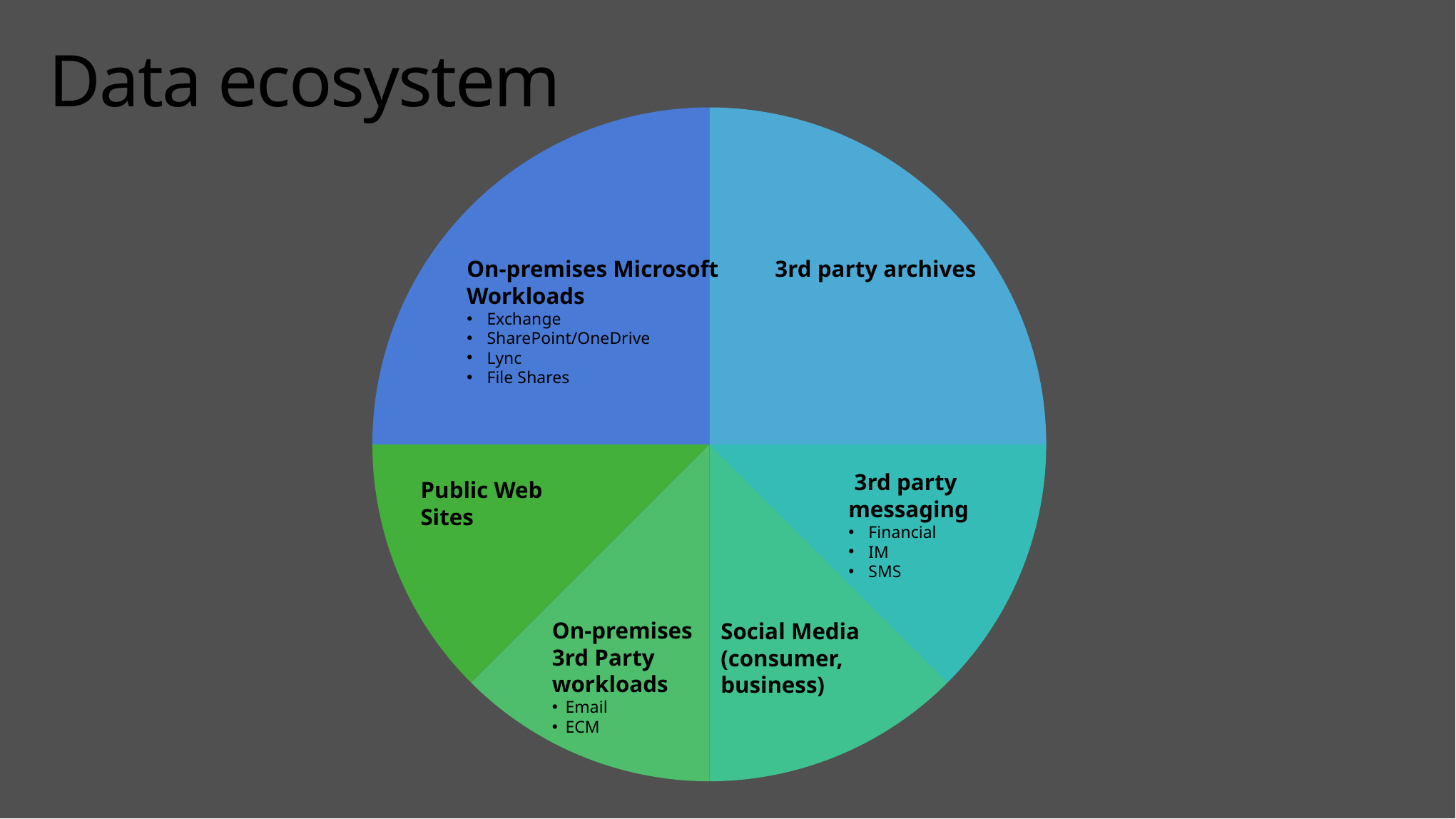
Which slice is larger, On-premises 3rd Party workloads or On-premises Microsoft Workloads? On-premises Microsoft Workloads What is the title of the slide containing the pie chart? Data ecosystem Which slice is larger, 3rd party messaging or 3rd party archives? 3rd party archives Which slice is larger, On-premises Microsoft Workloads or Social Media (consumer, business)? On-premises Microsoft Workloads What kind of chart is shown on the slide? pie chart How many slices does the pie chart have? 6 Which items are listed under the 3rd party messaging slice? Financial, IM, SMS